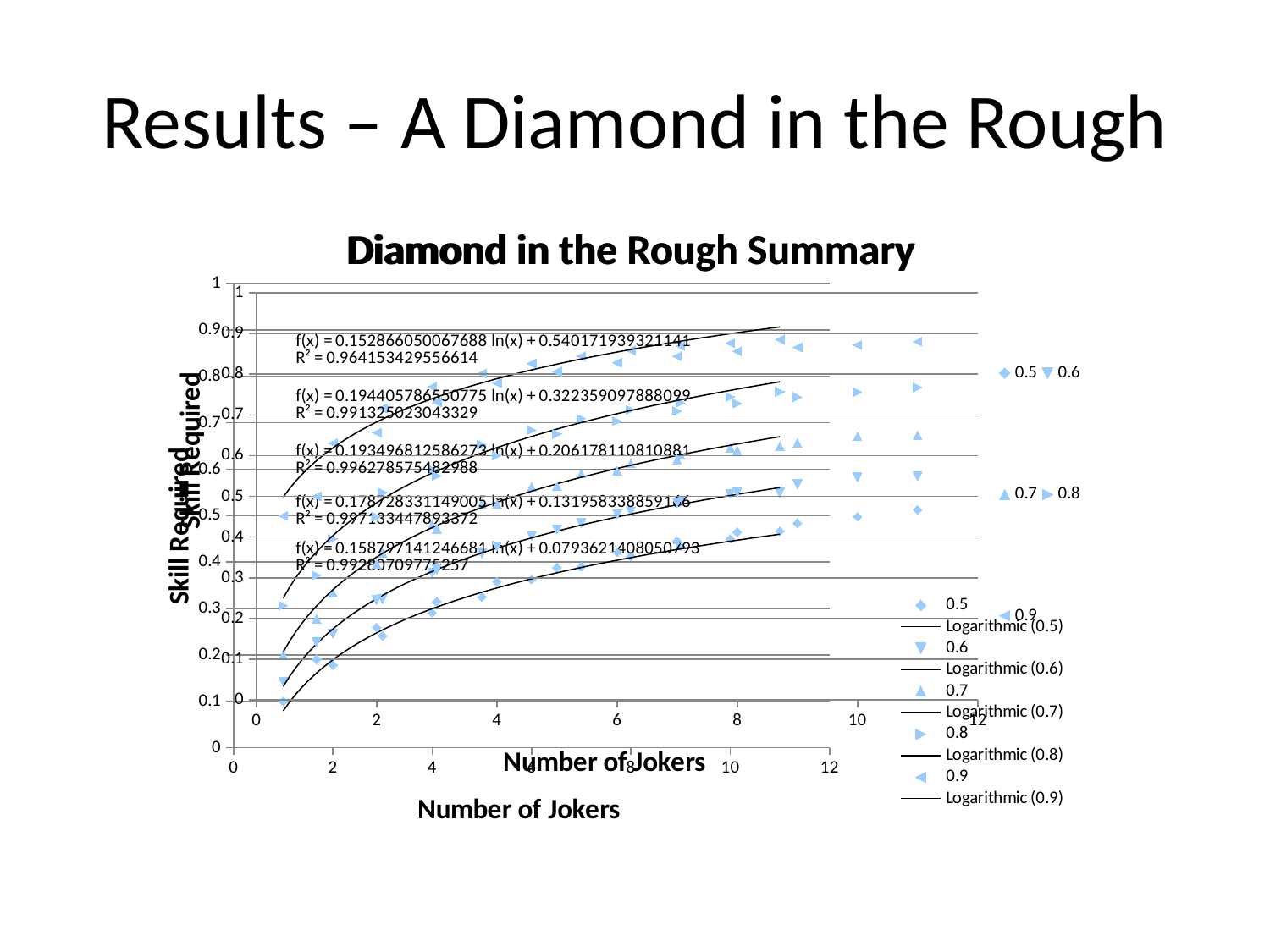
Which is larger, the R² of the topmost trendline or the R² of the second trendline from the top? the second trendline from the top Which series has the lowest Skill Required values across the chart? 0.5 What is the R² value printed for the topmost trendline equation? 0.964153429556614 How many data series (excluding the logarithmic trendlines) does the legend list? 5 Which series has the highest Skill Required values across the chart? 0.9 What is the R² value printed for the second trendline equation from the top? 0.991325023043329 How many logarithmic trendlines does the legend list? 5 What is the coefficient of ln(x) in the topmost trendline equation? 0.152866050067688 What kind of chart is shown on the slide? scatter chart What is the title of the chart? Diamond in the Rough Summary Do the Skill Required values rise or fall as the Number of Jokers increases? rise What is the label of the x axis of the chart? Number of Jokers